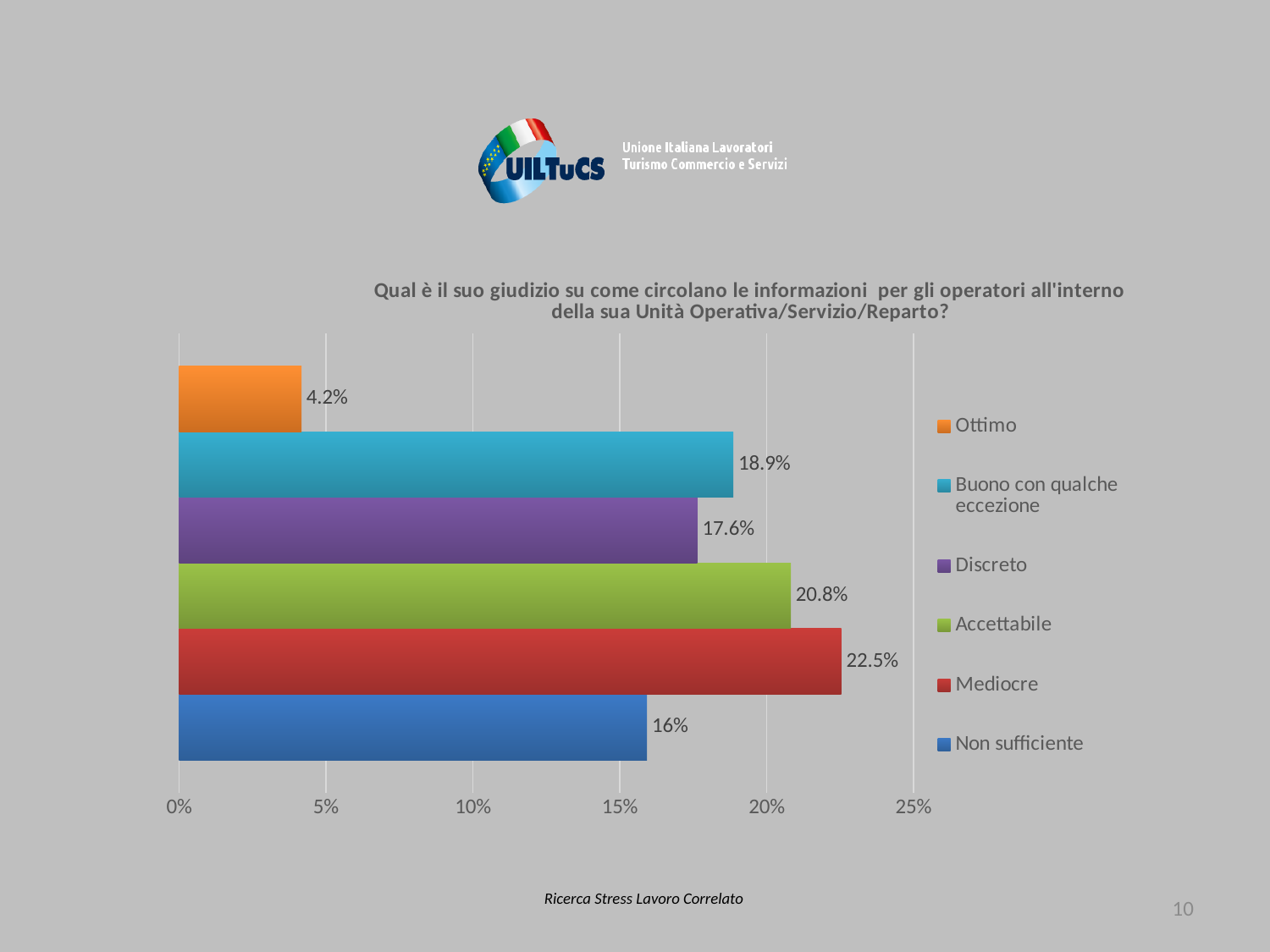
Which is larger, the value for Discreto or the value for Buono con qualche eccezione? Buono con qualche eccezione What is the value for Ottimo? 4.2% Which category has the lowest value? Ottimo What is the value for Buono con qualche eccezione? 18.9% What is the value for Mediocre? 22.5% What colour is the bar for Accettabile? green Which category has the highest value? Mediocre What kind of chart is shown on the slide? bar chart What is the value for Non sufficiente? 16% How many series does the legend list? 6 What is the difference between the values for Mediocre and Accettabile? 1.7% Is the value for Accettabile greater or less than 20%? greater